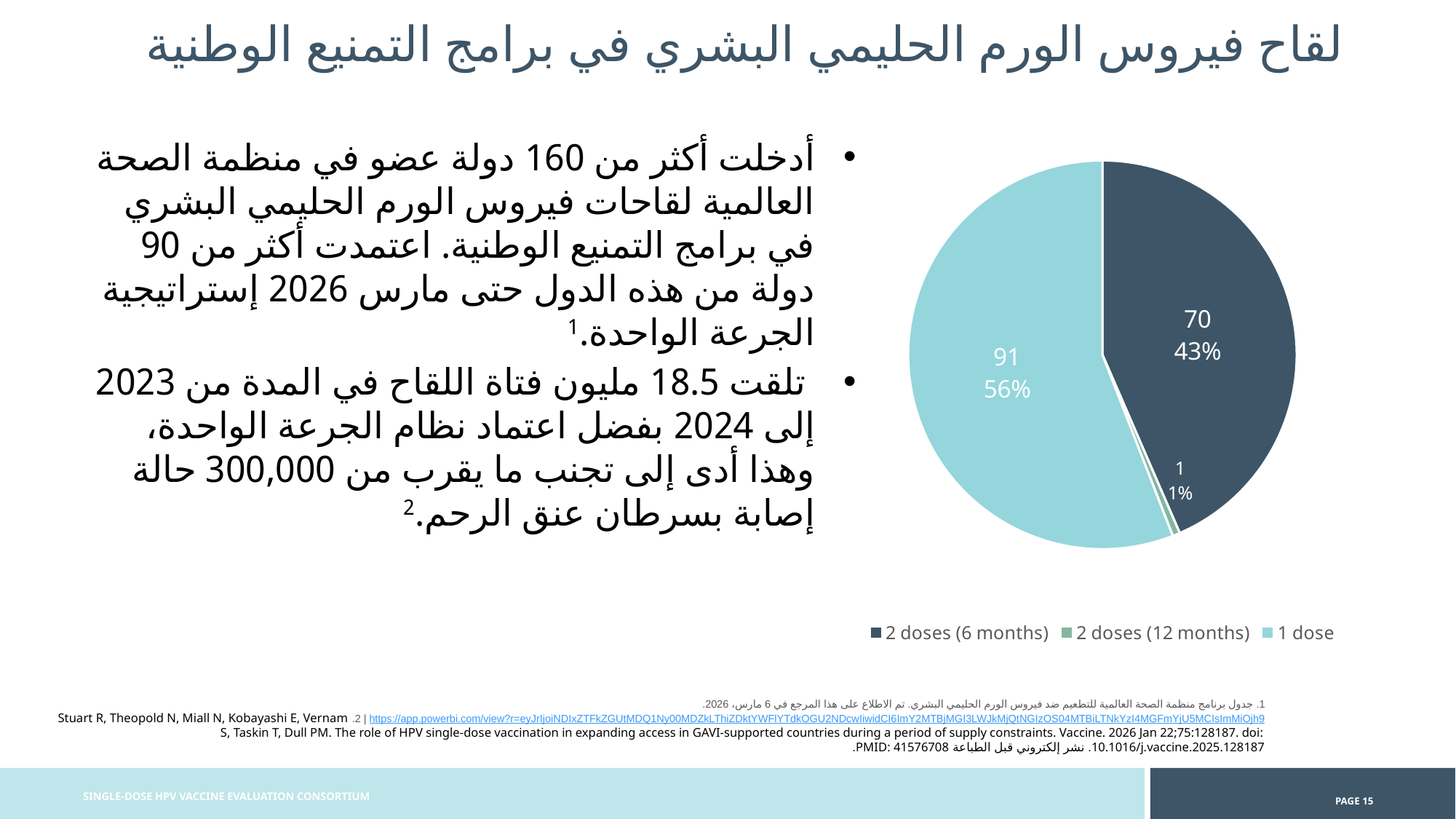
Which category has the smallest slice in the pie chart? 2 doses (12 months) What type of chart is shown on the slide? pie chart What percentage share of the pie does the "2 doses (6 months)" slice represent? 43% What is the difference between the values for "1 dose" and "2 doses (6 months)" in the pie chart? 21 What is the value shown for the "1 dose" slice of the pie chart? 91 What is the value shown for the "2 doses (6 months)" slice of the pie chart? 70 Which category has the largest slice in the pie chart? 1 dose What percentage share of the pie does the "1 dose" slice represent? 56% How many slices does the pie chart have? 3 What is the value shown for the "2 doses (12 months)" slice of the pie chart? 1 How many entries does the legend of the pie chart list? 3 Which is larger in the pie chart, the value for "1 dose" or the value for "2 doses (6 months)"? 1 dose